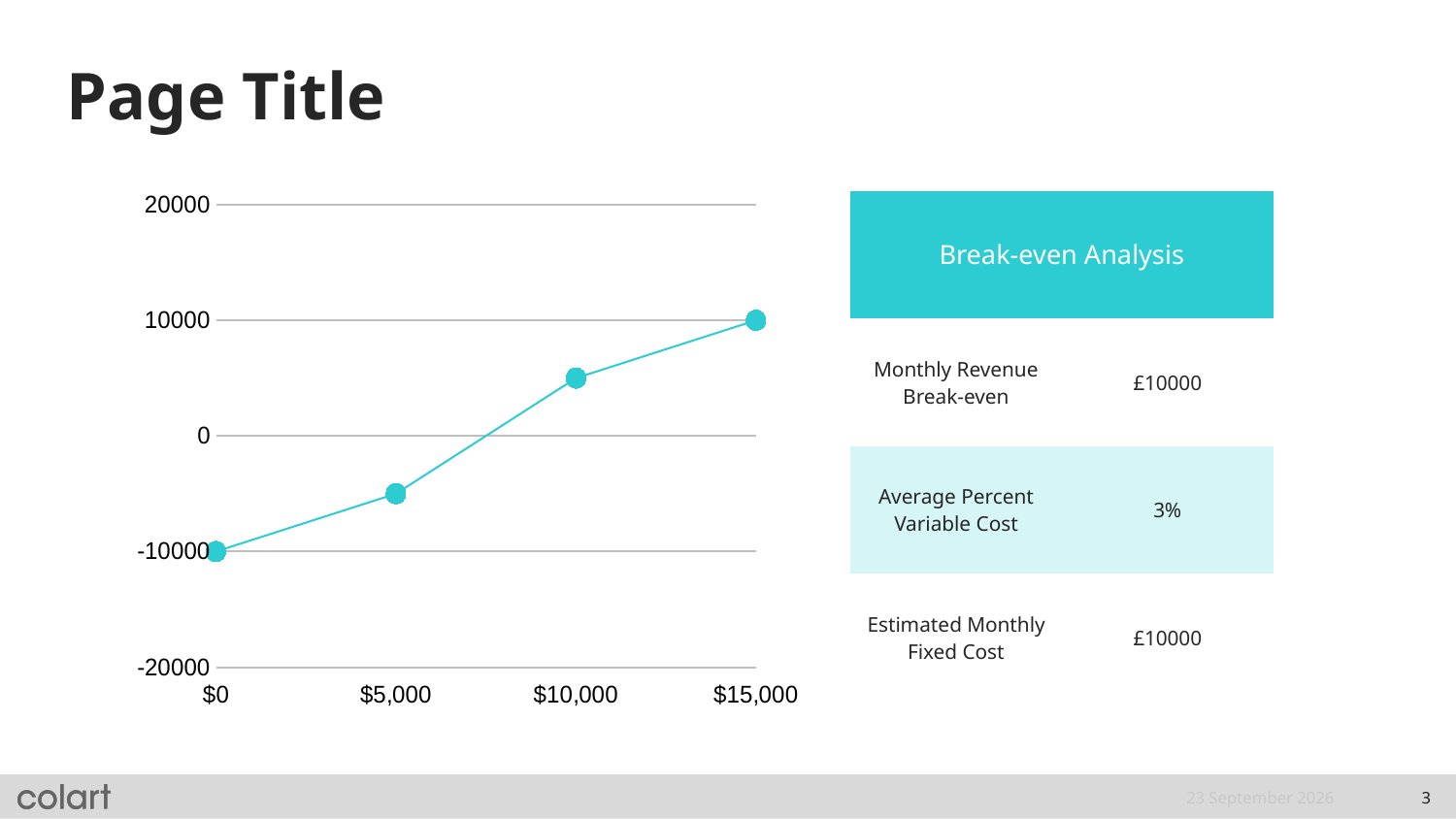
Which x-axis category has the lowest plotted value? $0 What is the plotted value at $15,000 on the x axis? 10000 What is the difference between the value at $15,000 and the value at $0? 20000 Which x-axis category has the highest plotted value? $15,000 Is the value at $10,000 greater or less than 10000? less What kind of chart is shown on the slide? line chart Is the value at $5,000 greater or less than 0? less Which is larger, the value at $5,000 or the value at $10,000? $10,000 Is the value at $10,000 greater or less than 0? greater Do the plotted values rise or fall as the x axis goes from $0 to $15,000? rise How many data points are plotted on the line chart? 4 What is the plotted value at $0 on the x axis? -10000